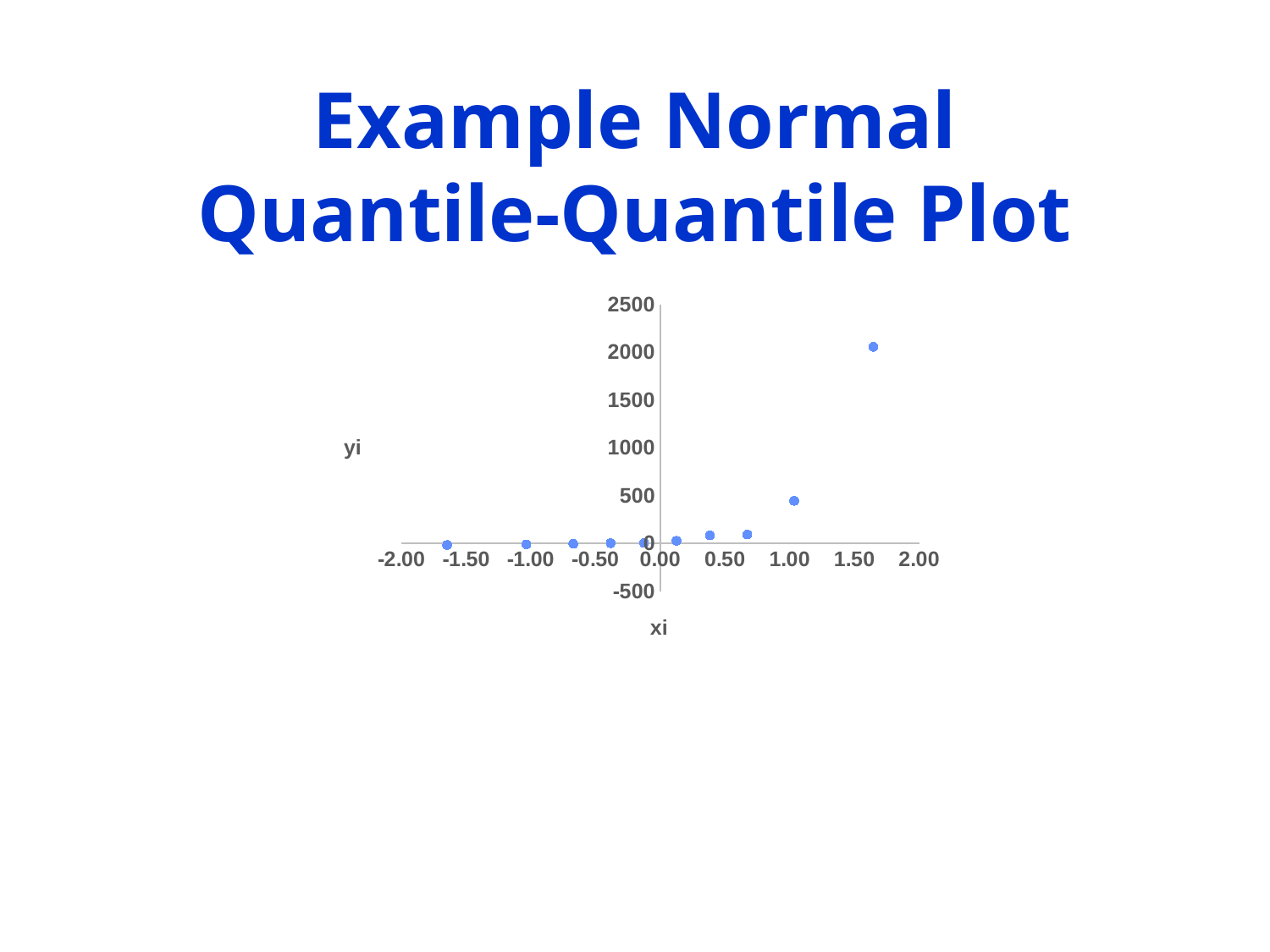
Do the yi values generally rise or fall as xi increases along the x axis? rise Which point has the highest yi value: the one near xi = 1.00 or the one near xi = 1.50? the one near xi = 1.50 Is the yi value of the rightmost point (near xi = 1.50) greater or less than 1500? greater What is the label of the horizontal axis? xi What is the highest value shown on the vertical axis? 2500 What kind of chart is shown on the slide? scatter plot Is the yi value of the point near xi = -1.50 greater or less than 500? less What is the lowest value shown on the horizontal axis? -2.00 Is the yi value of the point near xi = 1.00 greater or less than 1000? less